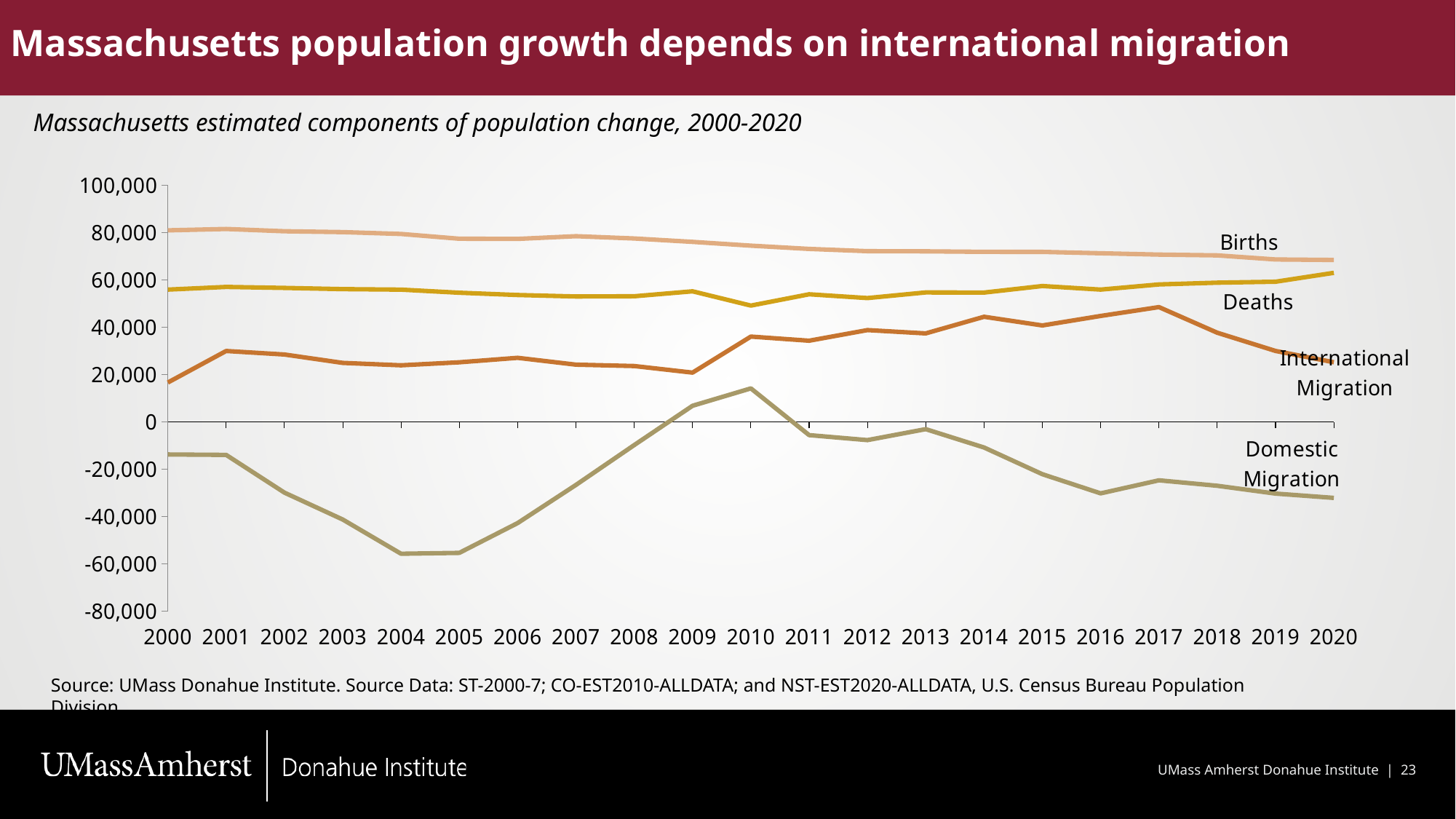
Is the value for Domestic Migration in 2004 greater or less than -40,000? less In which year does Domestic Migration reach its highest value? 2010 What kind of chart is shown on the slide? line chart Is the value for Births in 2020 greater or less than 80,000? less How many years are shown along the x axis of the chart? 21 In which year does International Migration reach its highest value? 2017 Is the value for Domestic Migration in 2010 greater or less than 0? greater Which series has the highest values across the whole period? Births In 2020, which is larger: Births or Deaths? Births How many series (lines) are plotted on the chart? 4 Do Births rise or fall from 2000 to 2020? fall